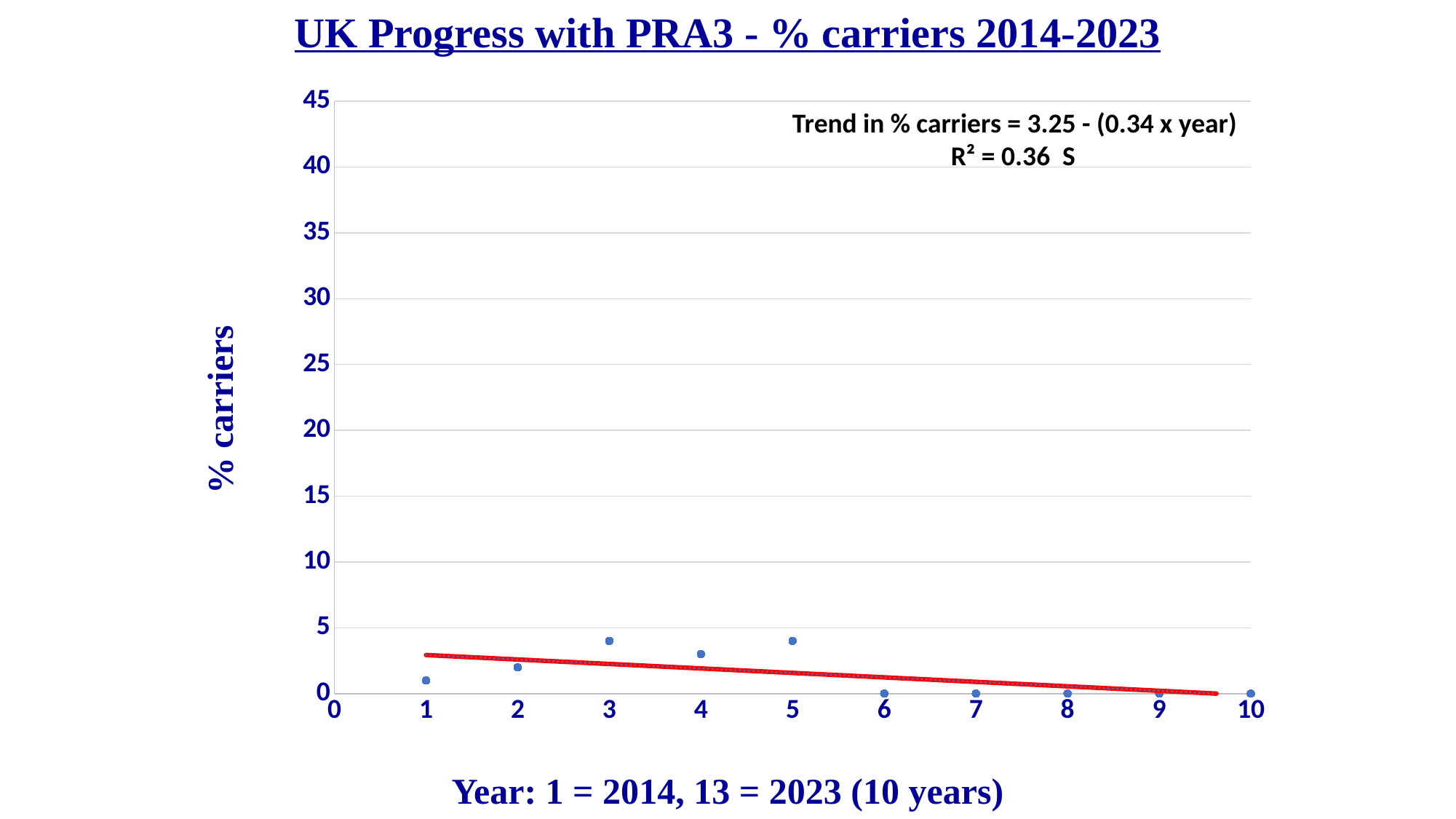
How many data points are plotted on the chart? 10 Which has the larger % carriers value, year 3 or year 1? year 3 What is the label on the vertical axis? % carriers Which has the larger % carriers value, year 5 or year 8? year 5 What is the highest value shown on the vertical axis? 45 What is the value of % carriers for year 6? 0 Is the value for year 1 greater or less than 5? less Does the trend line for % carriers rise or fall as the year increases? fall Is the value for year 3 greater or less than 5? less What kind of chart is shown on the slide? scatter chart What is the title of the chart? UK Progress with PRA3 - % carriers 2014-2023 What is the value of % carriers for year 10? 0